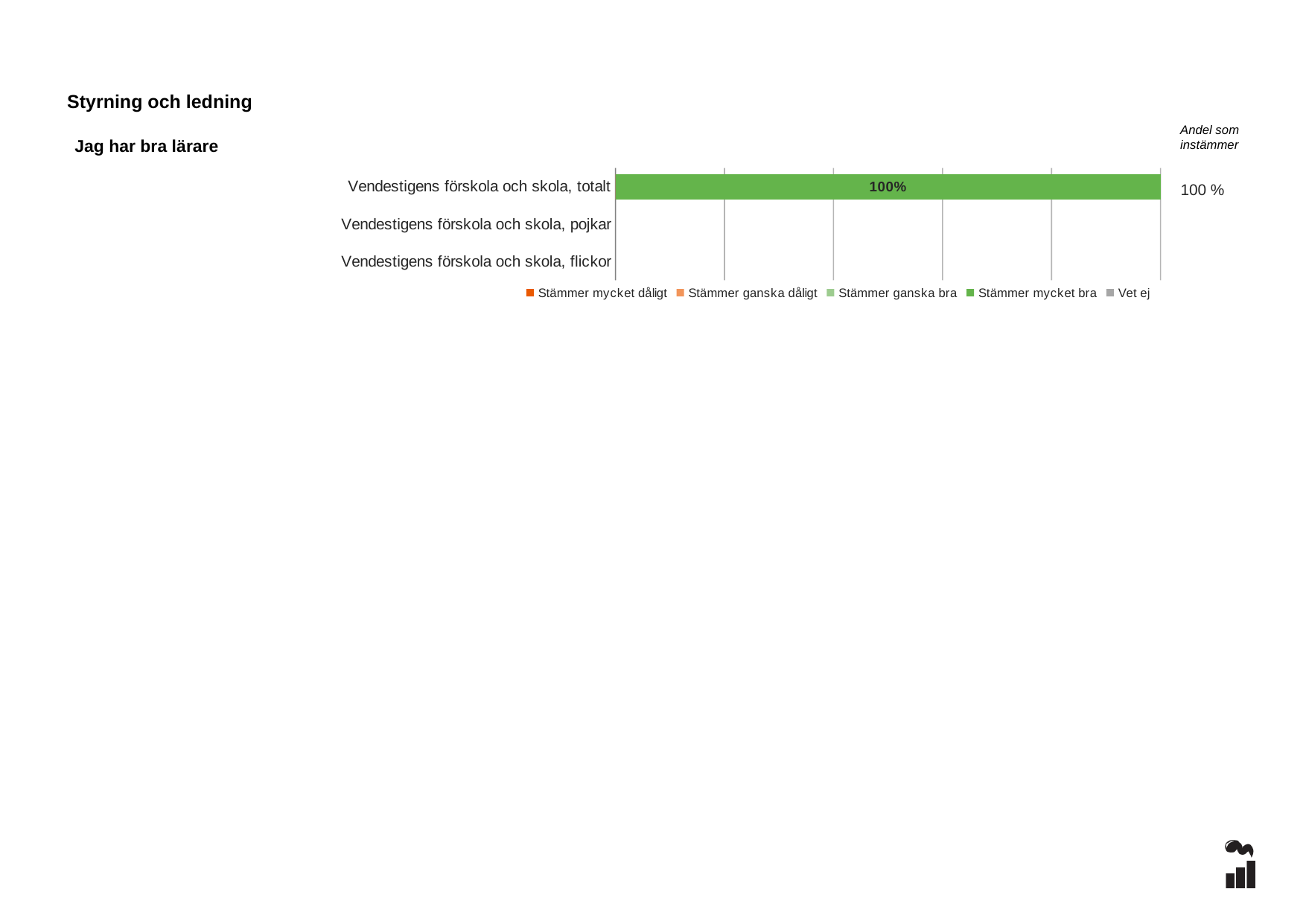
Which category has the highest value in the chart? Vendestigens förskola och skola, totalt How many categories are listed on the vertical axis of the chart? 3 How many series does the legend list? 5 What is the title of the chart? Jag har bra lärare What is the value of the 'Stämmer mycket bra' segment for 'Vendestigens förskola och skola, totalt'? 100% Which legend entry corresponds to the dark green colour? Stämmer mycket bra Is the value for 'Vendestigens förskola och skola, totalt' greater or less than 50%? greater What is the total of the stacked bar for 'Vendestigens förskola och skola, totalt'? 100% What kind of chart is shown on the slide? bar chart What is the 'Andel som instämmer' value shown for 'Vendestigens förskola och skola, totalt'? 100 %